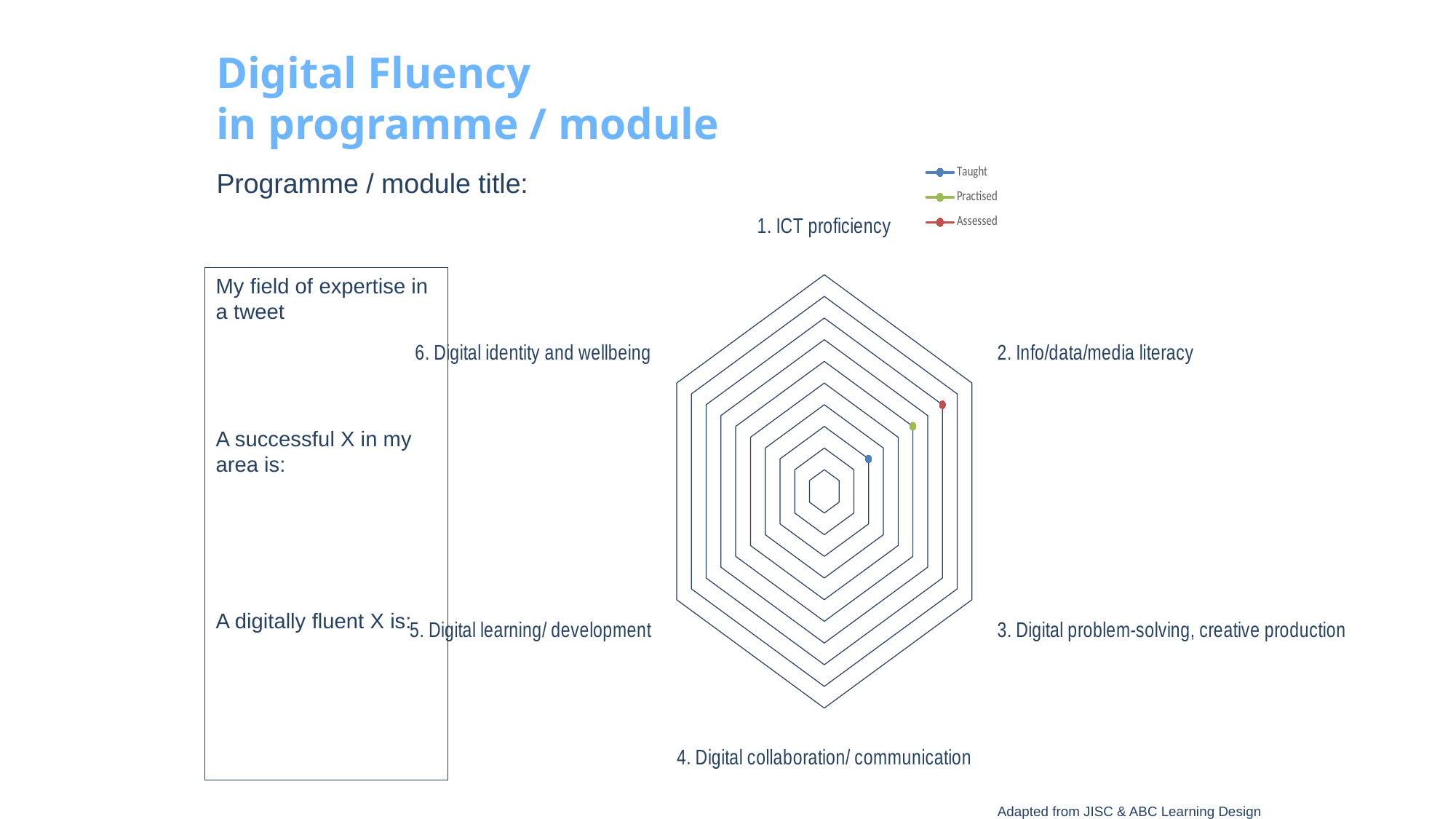
What are the three series named in the legend of the radar chart? Taught, Practised, Assessed On which category axis are the plotted data points of the radar chart located? 2. Info/data/media literacy Which category is labelled at the top of the radar chart? 1. ICT proficiency Which category is labelled at the bottom of the radar chart? 4. Digital collaboration/ communication On the axis for 2. Info/data/media literacy, is the Assessed point or the Practised point further from the centre? Assessed What kind of chart is shown on the slide? Radar chart On the axis for 2. Info/data/media literacy, is the Practised point or the Taught point further from the centre? Practised How many categories (axes) does the radar chart have? 6 On the axis for 2. Info/data/media literacy, which series has the point furthest from the centre? Assessed On the axis for 2. Info/data/media literacy, which series has the point closest to the centre? Taught How many series does the legend of the radar chart list? 3